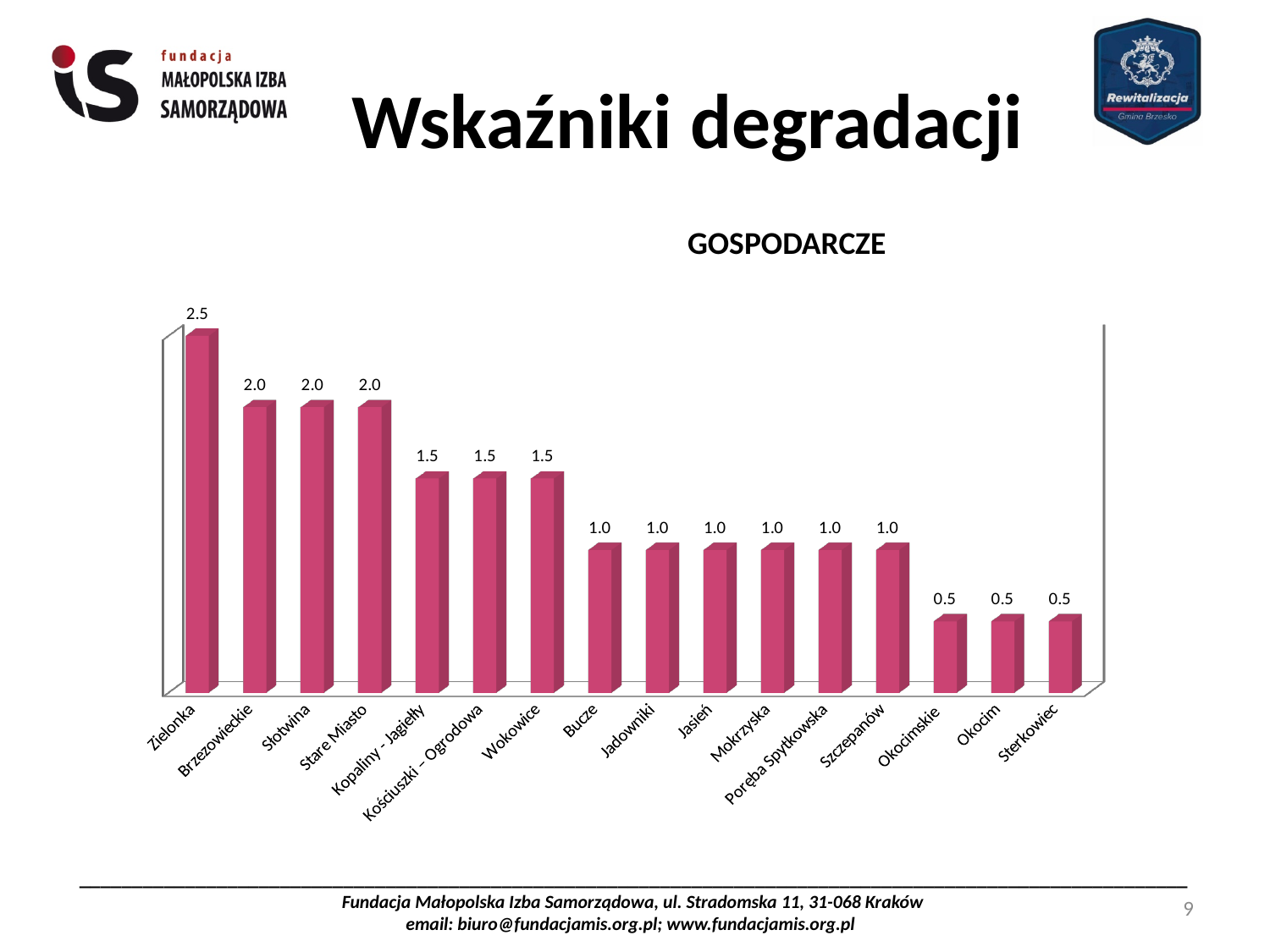
Which is larger, the value for Słotwina or the value for Jasień? Słotwina What kind of chart is shown on the slide? Bar chart What is the difference between the values for Brzezowieckie and Bucze? 1.0 Which category has the highest value? Zielonka What is the value for Mokrzyska? 1.0 What is the difference between the values for Zielonka and Okocim? 2.0 What is the value for Wokowice? 1.5 What is the value for Zielonka? 2.5 How many categories are shown on the chart? 16 What is the value for Stare Miasto? 2.0 What is the value for Sterkowiec? 0.5 What is the title of the chart? GOSPODARCZE